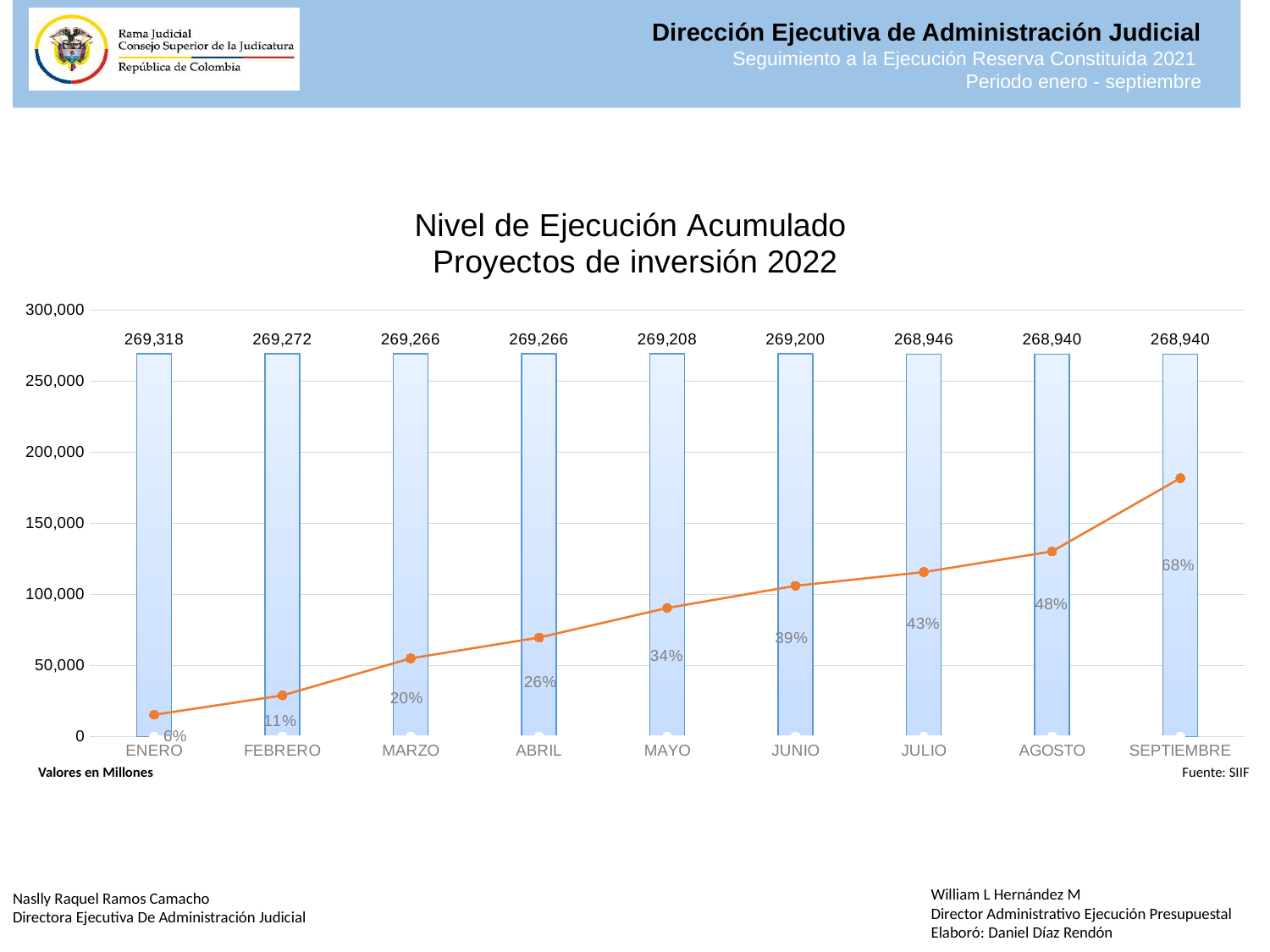
Is the line point for SEPTIEMBRE greater or less than 150,000? greater Do the percentages on the line rise or fall from ENERO to SEPTIEMBRE? Rise Which has the larger bar value, JUNIO or JULIO? JUNIO Which month has the highest bar value? ENERO Which month has the lowest percentage on the line? ENERO What is the difference between the bar values for ENERO and SEPTIEMBRE? 378 What percentage is shown on the line for MAYO? 34% What is the bar value for ENERO? 269,318 What kind of chart is this? Combined bar and line chart How many months are shown on the x axis? 9 What is the bar value for JULIO? 268,946 What percentage is shown on the line for SEPTIEMBRE? 68%